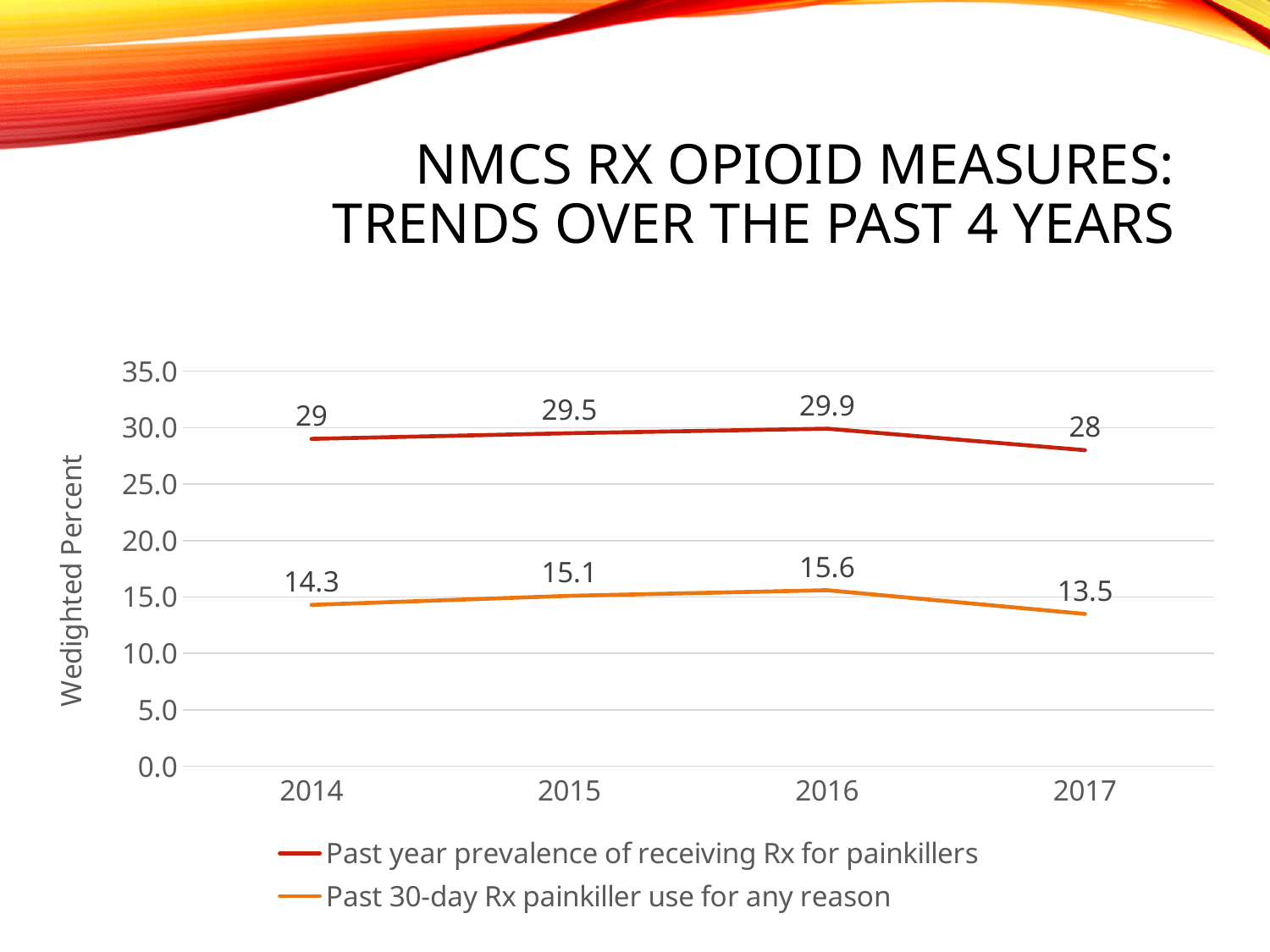
How many years are shown on the x axis? 4 What kind of chart is shown on the slide? Line chart What is the value for 'Past 30-day Rx painkiller use for any reason' in 2014? 14.3 What is the difference between the two series in 2015? 14.4 What is the value for 'Past 30-day Rx painkiller use for any reason' in 2017? 13.5 What is the label of the y axis? Wedighted Percent What is the value for 'Past year prevalence of receiving Rx for painkillers' in 2016? 29.9 How many series does the legend list? 2 What is the difference between the 2016 and 2017 values for 'Past year prevalence of receiving Rx for painkillers'? 1.9 Which series has the larger value in 2014? Past year prevalence of receiving Rx for painkillers In which year is 'Past 30-day Rx painkiller use for any reason' highest? 2016 In which year is 'Past year prevalence of receiving Rx for painkillers' lowest? 2017